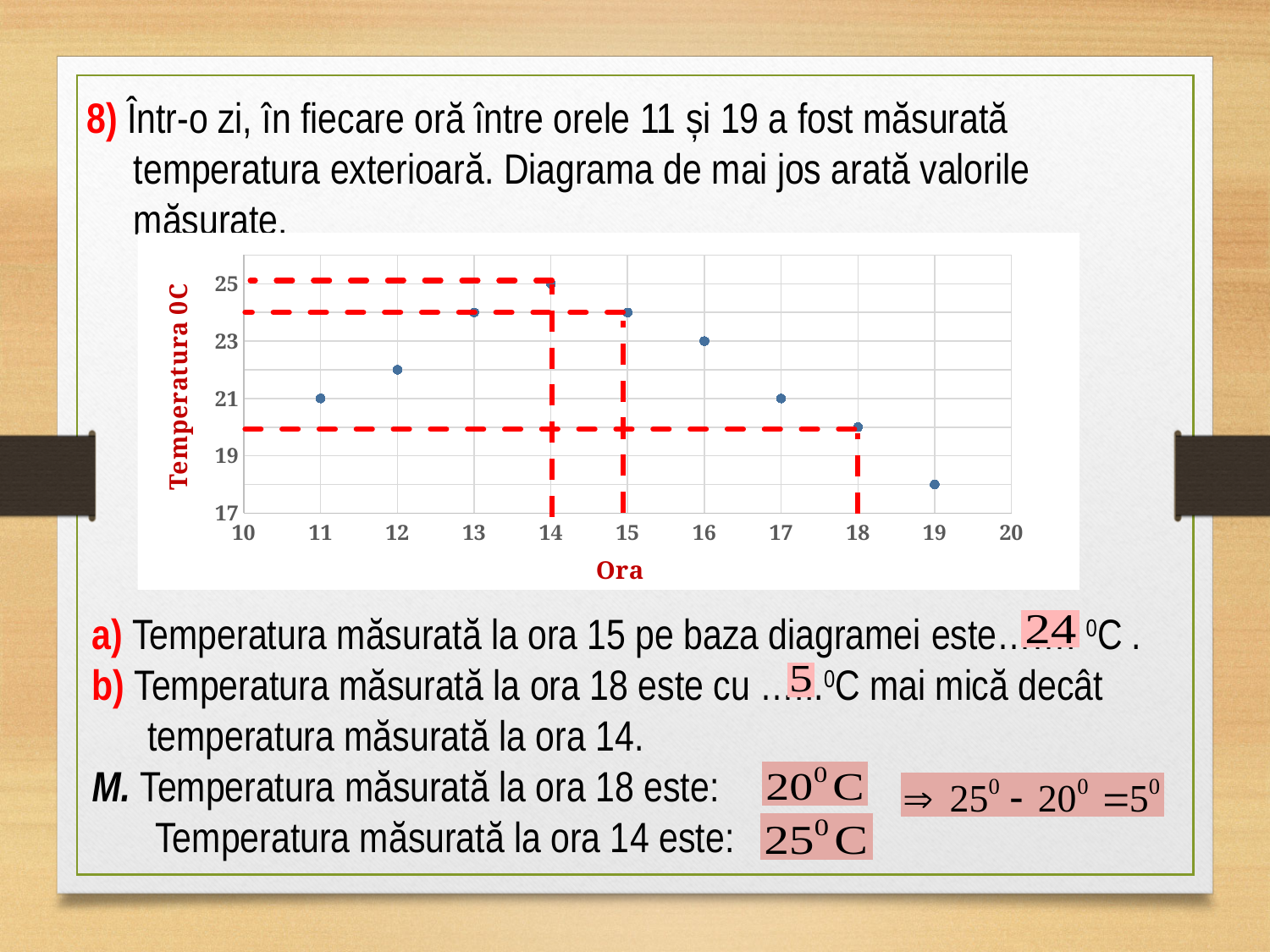
What is the title of the horizontal axis? Ora What is the temperature measured at hour 15? 24 What is the temperature measured at hour 18? 20 At which hour is the measured temperature lowest? 19 What is the temperature measured at hour 14? 25 At which hour is the measured temperature highest? 14 What kind of chart is shown on the slide? scatter chart By how much is the temperature at hour 14 higher than the temperature at hour 18? 5 What is the temperature measured at hour 11? 21 Is the temperature at hour 19 greater or less than 19? less How many hourly measurements are plotted on the chart? 9 What is the temperature measured at hour 16? 23